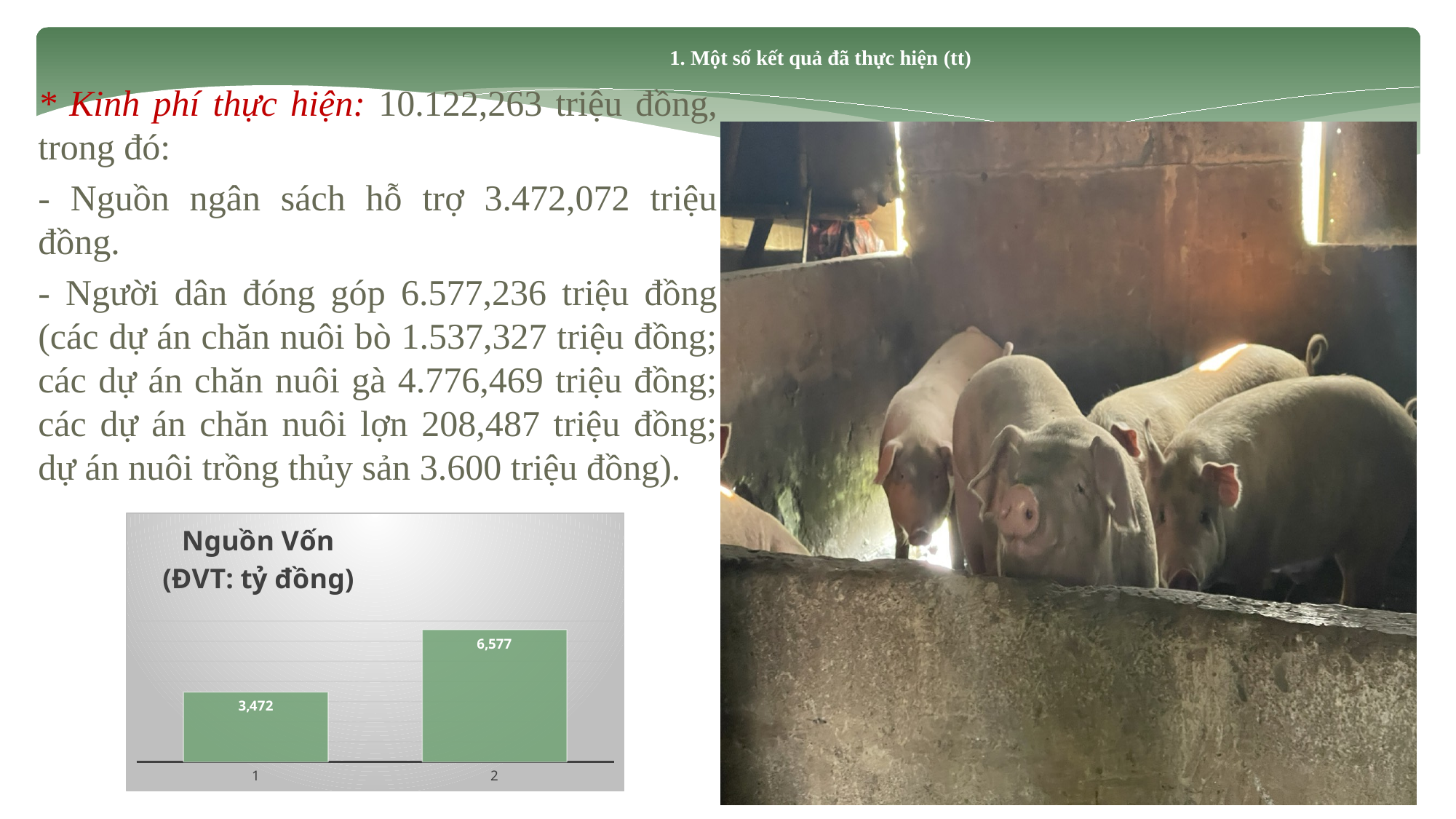
In the Nguồn Vốn chart, which is larger: the value for category 1 or category 2? category 2 What unit is stated under the title of the Nguồn Vốn chart? tỷ đồng What is the difference between the values for category 2 and category 1 in the Nguồn Vốn chart? 3,105 What is the title of the chart on the slide? Nguồn Vốn Which category has the highest value in the Nguồn Vốn chart? 2 What kind of chart is the Nguồn Vốn chart? bar chart What is the value for category 1 in the Nguồn Vốn chart? 3,472 What is the value for category 2 in the Nguồn Vốn chart? 6,577 Which category has the lowest value in the Nguồn Vốn chart? 1 How many bars are shown in the Nguồn Vốn chart? 2